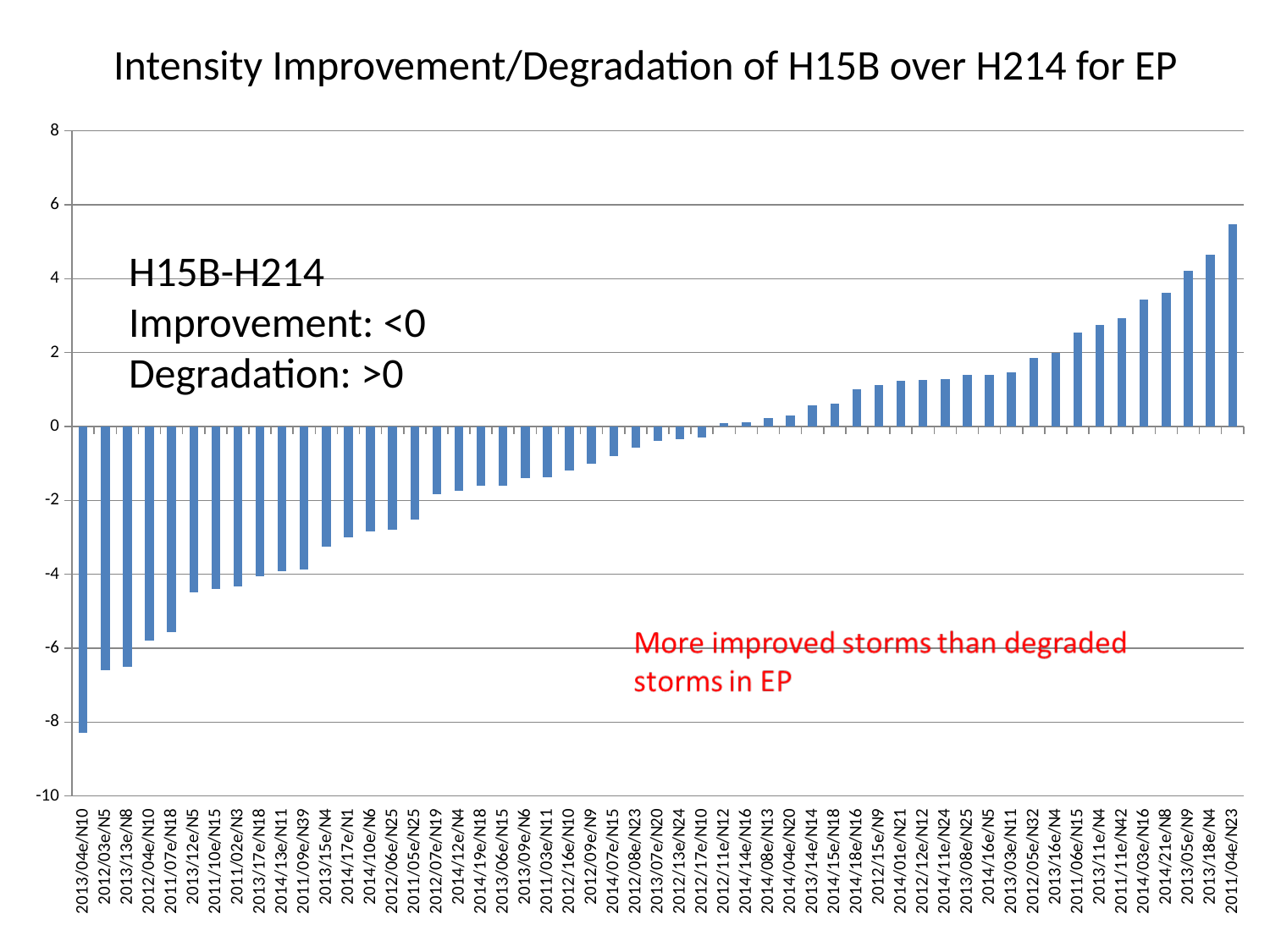
Is the value for 2013/18e/N4 greater or less than 4? greater Which category has the highest value? 2011/04e/N23 What kind of chart is shown on the slide? bar chart Is the value for 2011/04e/N23 greater or less than 4? greater Is the value for 2011/06e/N15 greater or less than 2? greater What is the title of the chart? Intensity Improvement/Degradation of H15B over H214 for EP Do the values rise or fall moving from left to right along the x axis? rise According to the red annotation on the chart, are there more improved or more degraded storms in EP? more improved storms Which category has the lowest value? 2013/04e/N10 Which has the lower value, 2013/04e/N10 or 2012/03e/N5? 2013/04e/N10